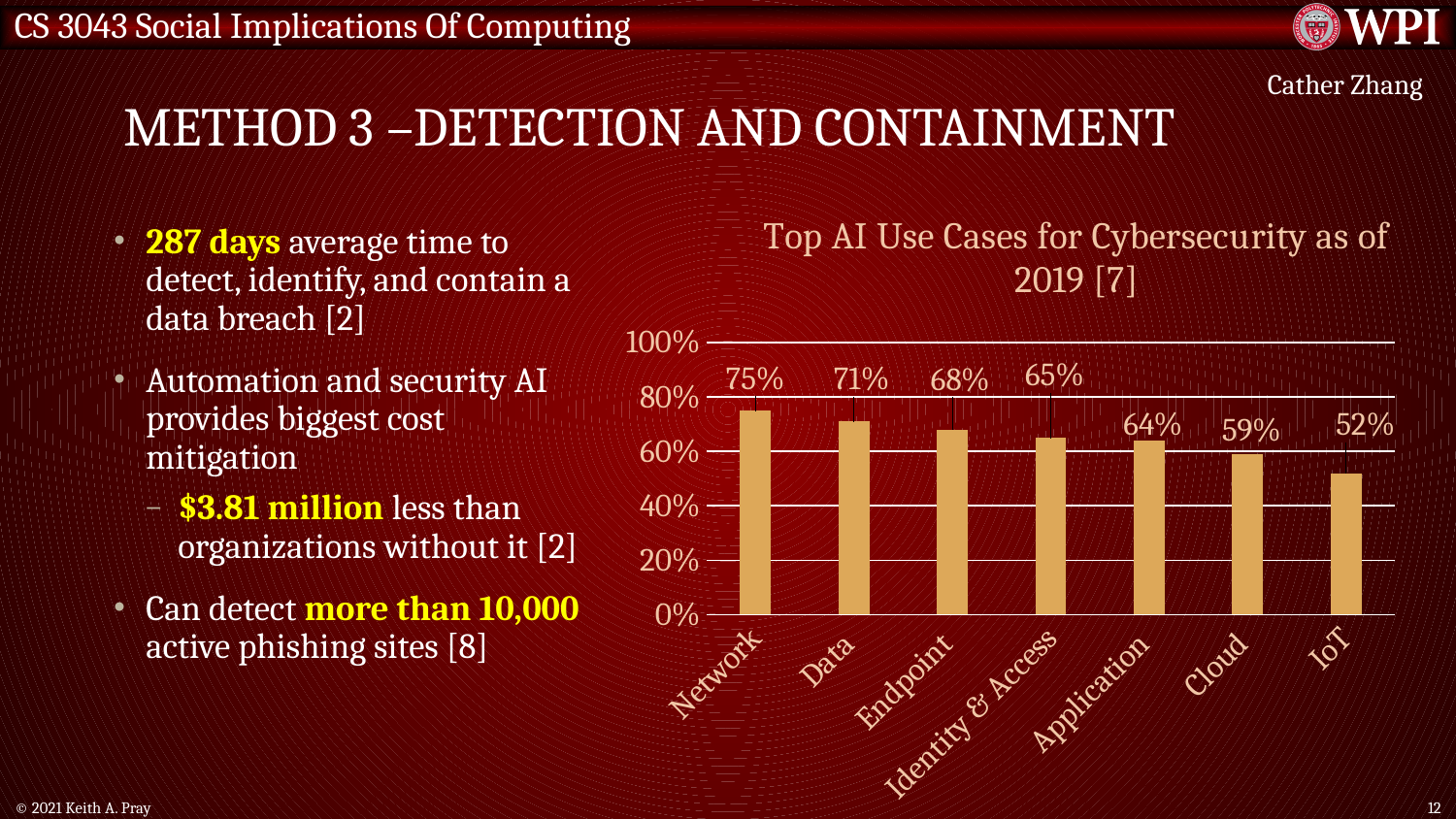
Which category has the highest value? Network What kind of chart is shown on the slide? Bar chart How many categories are shown in the chart? 7 Is the value for Cloud greater or less than 40%? greater What is the title of the chart? Top AI Use Cases for Cybersecurity as of 2019 [7] What is the difference between the values for Network and IoT? 23% What is the difference between the values for Data and Cloud? 12% What is the value for IoT? 52% Which category has the lowest value? IoT What is the value for Identity & Access? 65% Which is larger, the value for Endpoint or the value for Application? Endpoint What is the value for Network? 75%